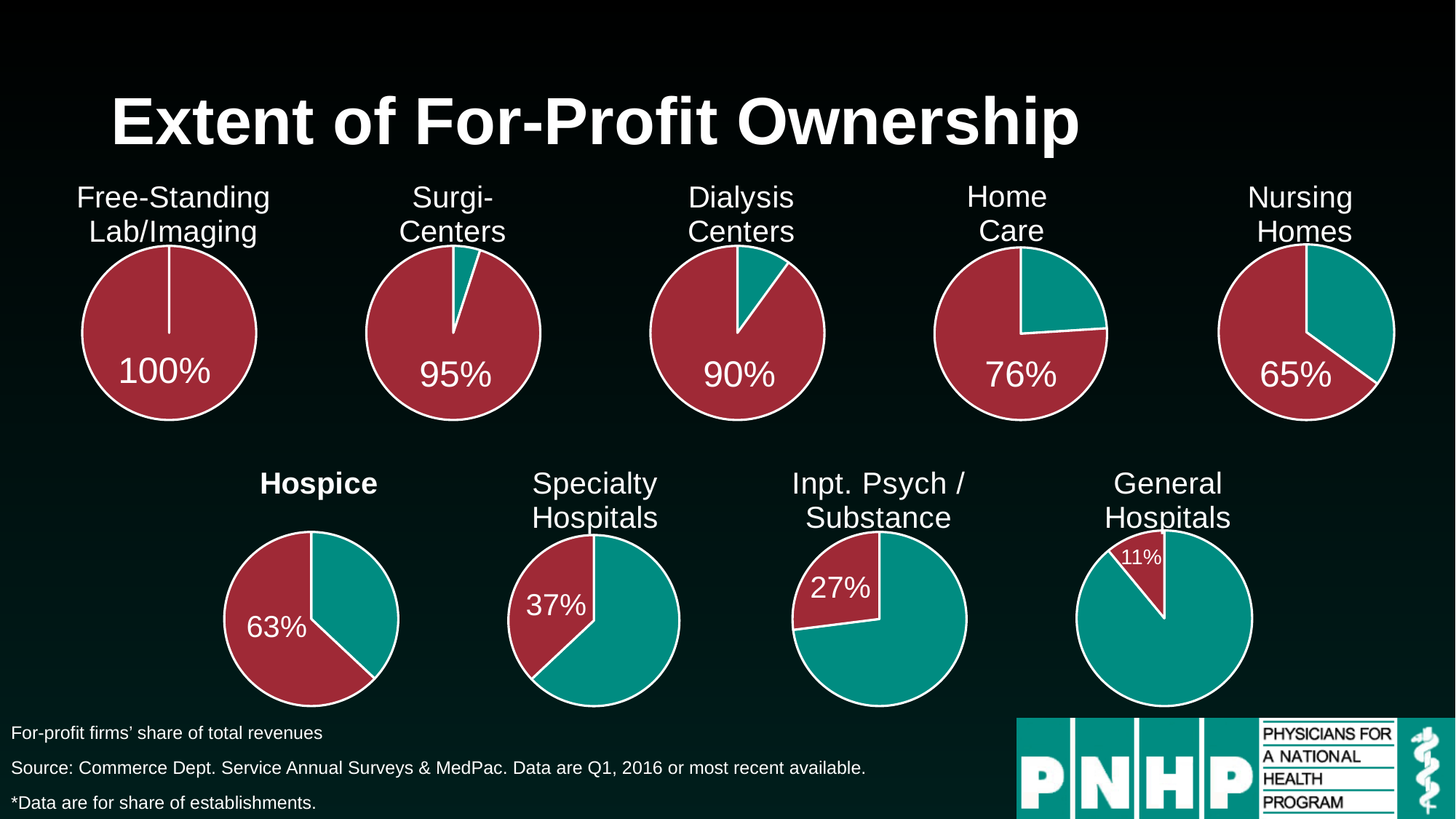
Across all the pie charts on the slide, which category has the highest for-profit share? Free-Standing Lab/Imaging What is the title of the slide containing the pie charts? Extent of For-Profit Ownership What is the difference between the percentage on the Nursing Homes pie chart and the percentage on the Hospice pie chart? 2% On the Home Care pie chart, what percentage is labelled? 76% Which is larger: the percentage on the Specialty Hospitals pie chart or the percentage on the Inpt. Psych / Substance pie chart? Specialty Hospitals On the General Hospitals pie chart, what percentage is labelled on the red slice? 11% On the Dialysis Centers pie chart, what percentage is labelled? 90% On the Surgi-Centers pie chart, what percentage is labelled? 95% What kind of chart is used for each category on the slide? Pie chart Across all the pie charts on the slide, which category has the lowest for-profit share? General Hospitals How many pie charts are shown on the slide? 9 On the Free-Standing Lab/Imaging pie chart, what for-profit share is shown? 100%